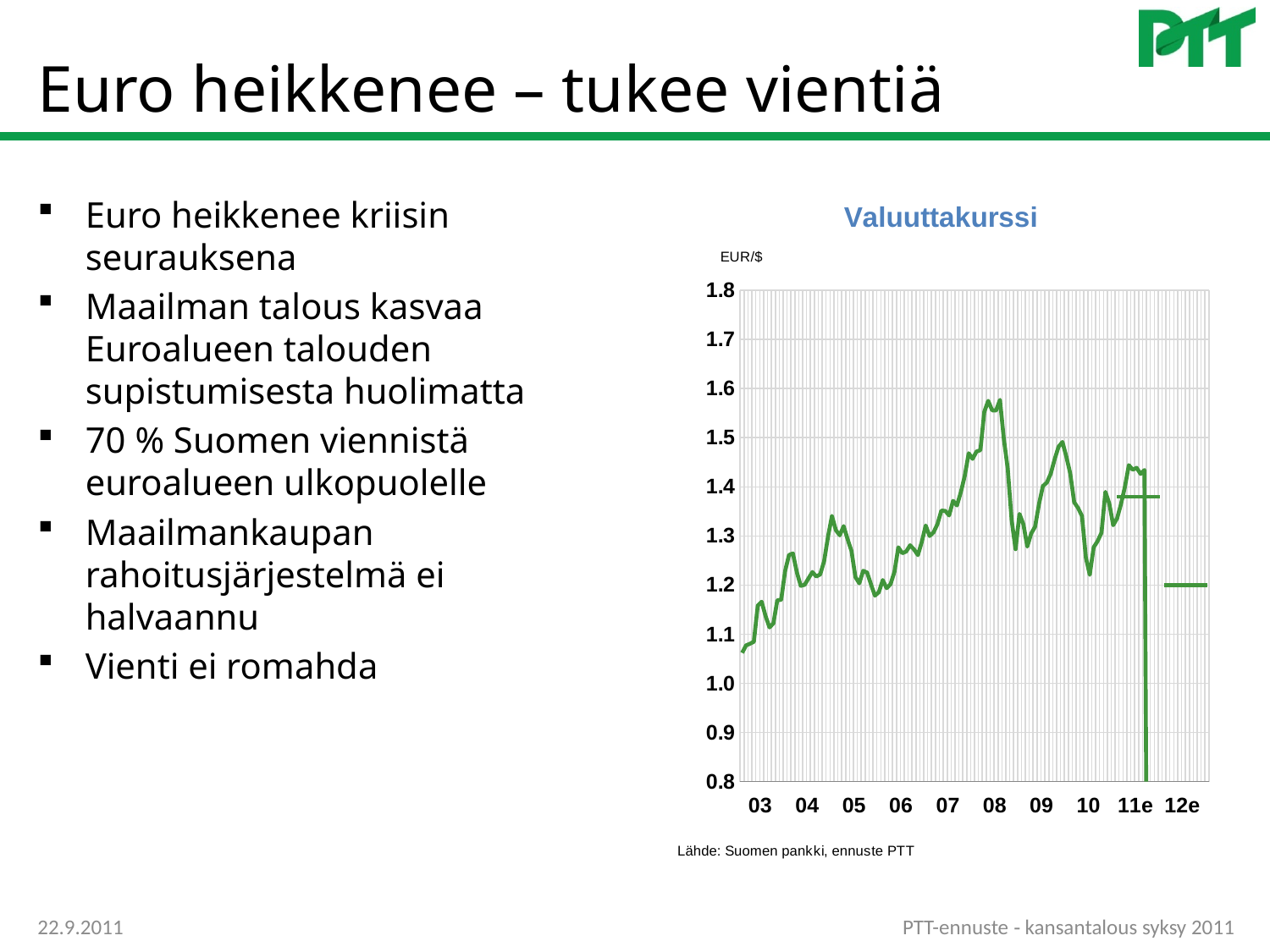
What is the highest value shown on the y axis of the chart? 1.8 Is the exchange rate at the start of 2003 greater or less than 1.2? less What is the title of the chart? Valuuttakurssi What unit is shown above the y axis of the chart? EUR/$ Is the forecast value for 11e greater or less than 1.3? greater Which forecast value is higher, 11e or 12e? 11e Does the exchange rate rise or fall from 2003 to 2008? rise How many year labels are shown on the x axis of the chart? 10 Is the forecast value for 12e greater or less than 1.3? less What kind of chart is shown on the slide? line chart